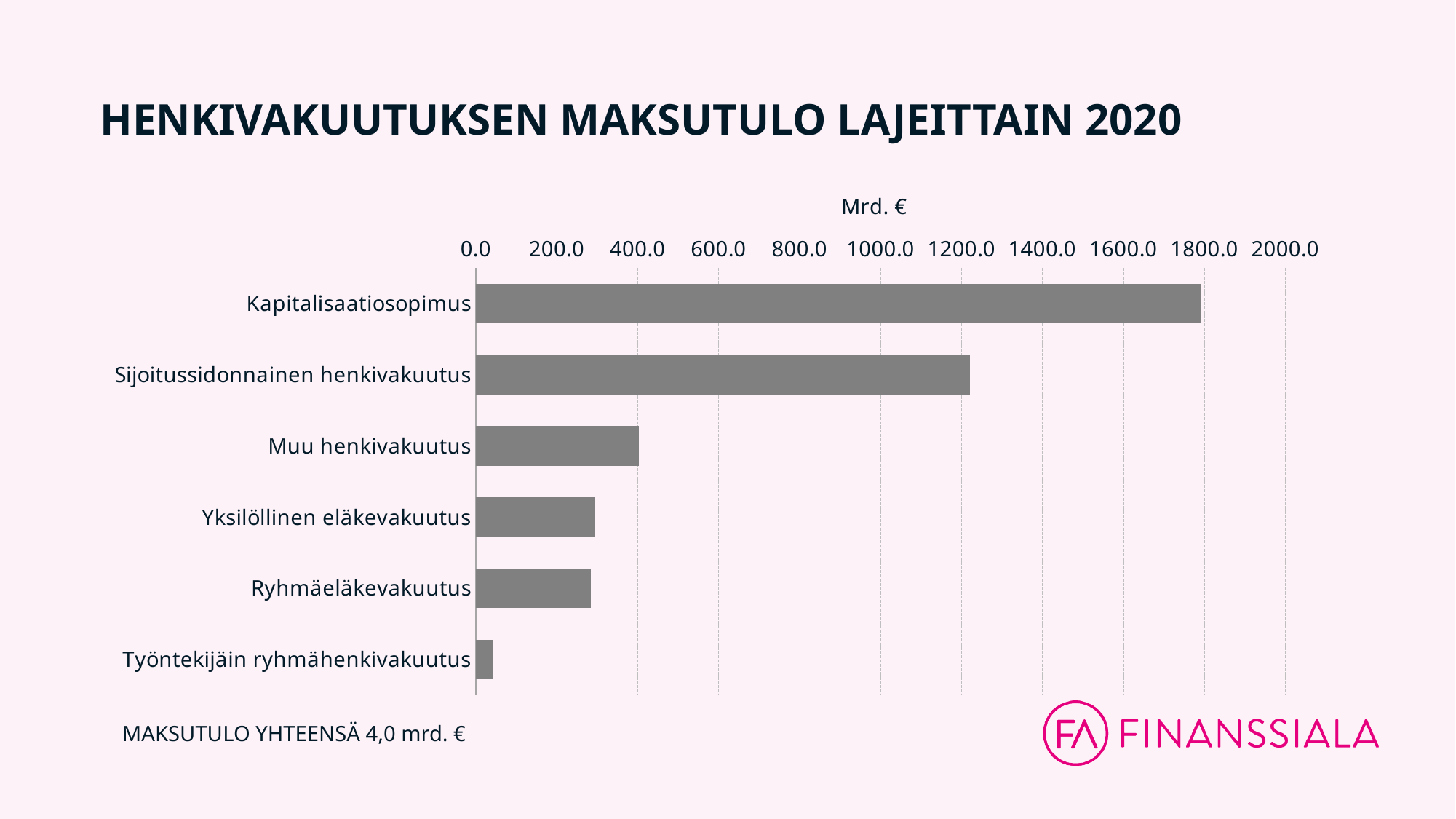
What kind of chart is shown on the slide? bar chart Which category has the lowest value? Työntekijäin ryhmähenkivakuutus What is the title of the chart? HENKIVAKUUTUKSEN MAKSUTULO LAJEITTAIN 2020 Which is larger, the value for Kapitalisaatiosopimus or the value for Sijoitussidonnainen henkivakuutus? Kapitalisaatiosopimus Is the value for Sijoitussidonnainen henkivakuutus greater or less than 1400.0? less Is the value for Kapitalisaatiosopimus greater or less than 1600.0? greater Is the value for Muu henkivakuutus greater or less than 600.0? less Which category has the highest value? Kapitalisaatiosopimus How many categories are shown in the chart? 6